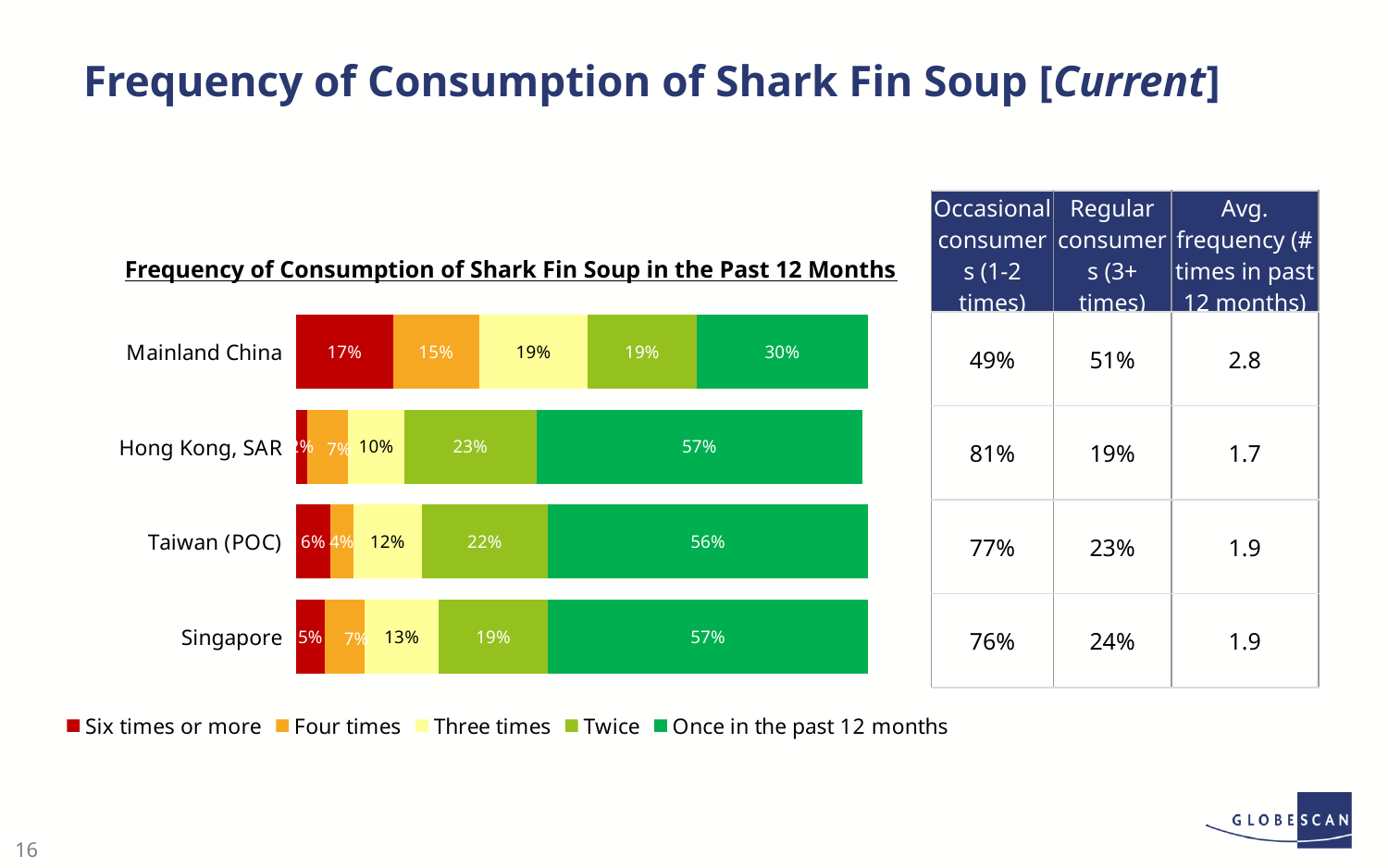
Which colour represents 'Six times or more' in the legend? Red What is the value for 'Twice' for Taiwan (POC)? 22% What percentage of Mainland China respondents consumed shark fin soup once in the past 12 months? 30% Which market has the highest value for 'Six times or more'? Mainland China Which is larger: the 'Twice' value for Taiwan (POC) or for Singapore? Taiwan (POC) For Mainland China, what is the difference between 'Once in the past 12 months' and 'Six times or more'? 13 percentage points What type of chart is used to show frequency of consumption? Stacked bar chart Which market has the lowest value for 'Once in the past 12 months'? Mainland China What is the value for 'Three times' for Singapore? 13% What is the value for 'Once in the past 12 months' for Hong Kong, SAR? 57% How many series does the chart legend list? 5 How many markets are shown in the bar chart? 4